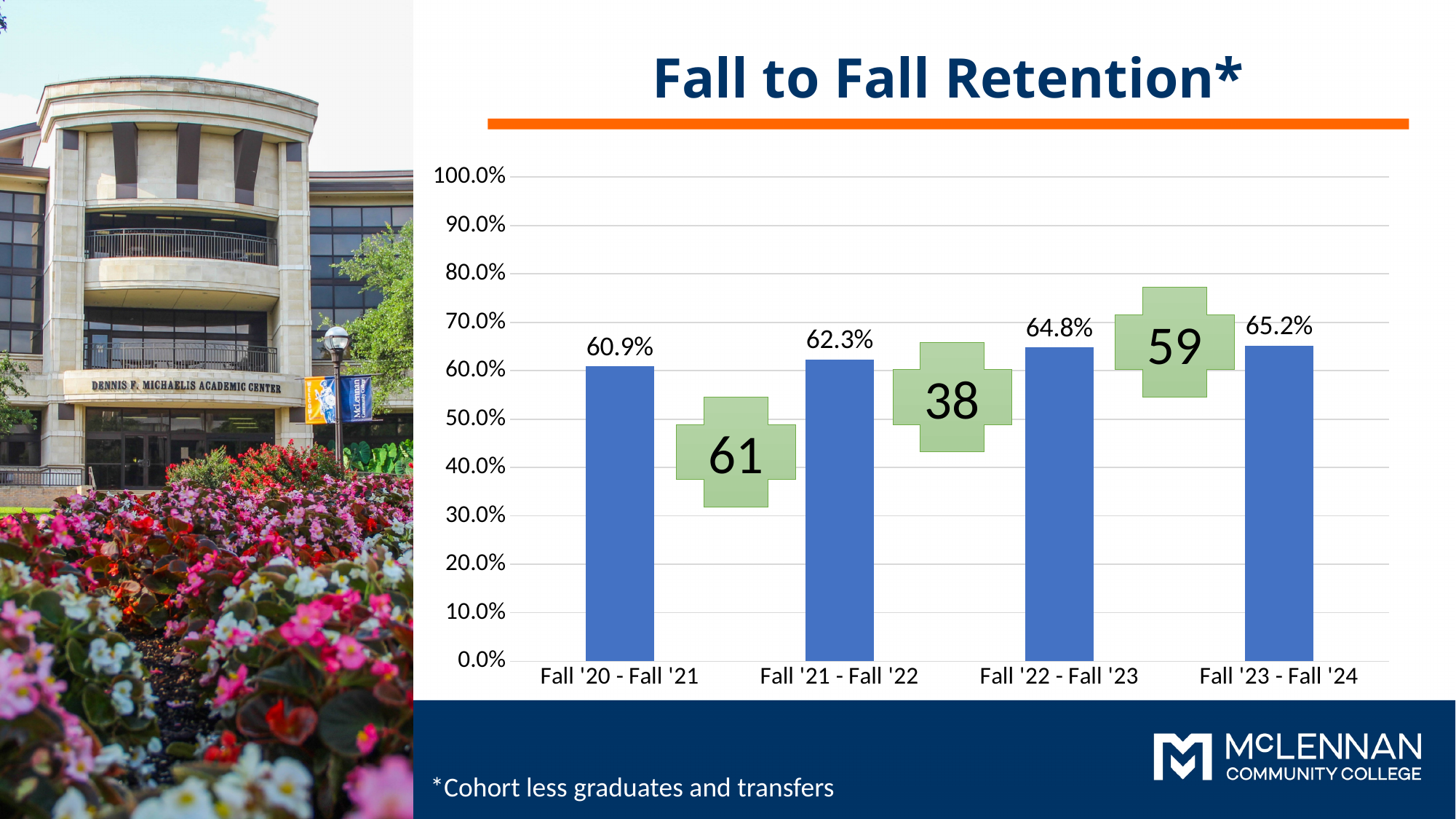
What is the Fall to Fall Retention value for Fall '22 - Fall '23? 64.8% What is the Fall to Fall Retention value for Fall '23 - Fall '24? 65.2% How many periods are shown on the x axis of the chart? 4 What is the Fall to Fall Retention value for Fall '20 - Fall '21? 60.9% Do the retention values rise or fall from Fall '20 - Fall '21 to Fall '23 - Fall '24? rise Is the retention value for Fall '20 - Fall '21 greater or less than 70.0%? less Which period has the lowest Fall to Fall Retention? Fall '20 - Fall '21 What kind of chart is shown on the slide? bar chart Which period has the highest Fall to Fall Retention? Fall '23 - Fall '24 Which is larger: the retention for Fall '21 - Fall '22 or for Fall '22 - Fall '23? Fall '22 - Fall '23 What is the difference in retention between Fall '23 - Fall '24 and Fall '22 - Fall '23? 0.4% What is the difference in retention between Fall '21 - Fall '22 and Fall '20 - Fall '21? 1.4%